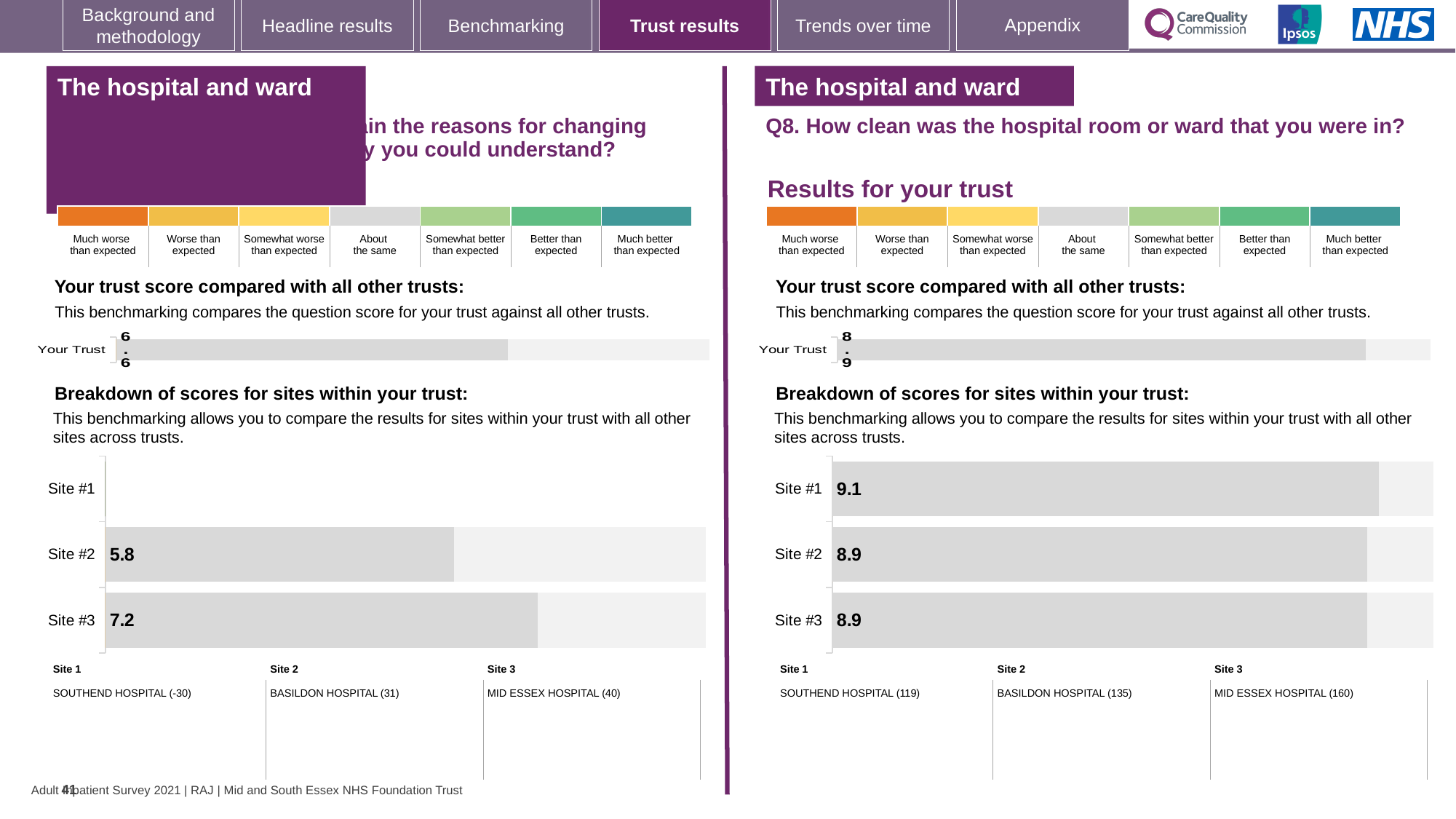
On the left-hand chart, what is the score for Site #3? 7.2 On the right-hand chart (Q8), how many sites are shown in the breakdown of scores? 3 On the left-hand chart, what is the score for Site #2? 5.8 On the left-hand chart, what is the 'Your Trust' score? 6.6 On the right-hand chart (Q8), what is the difference between the scores for Site #1 and Site #3? 0.2 On the right-hand chart (Q8), what is the 'Your Trust' score? 8.9 On the left-hand chart, which has the higher score, Site #2 or Site #3? Site #3 On the right-hand chart (Q8), which site has the highest score? Site #1 On the right-hand chart (Q8), what is the score for Site #2? 8.9 On the left-hand chart, what is the difference between the scores for Site #3 and Site #2? 1.4 On the right-hand chart (Q8, how clean was the hospital room or ward), what is the score for Site #1? 9.1 What kind of chart is used to show the breakdown of scores for sites on the right-hand side of the slide? Bar chart